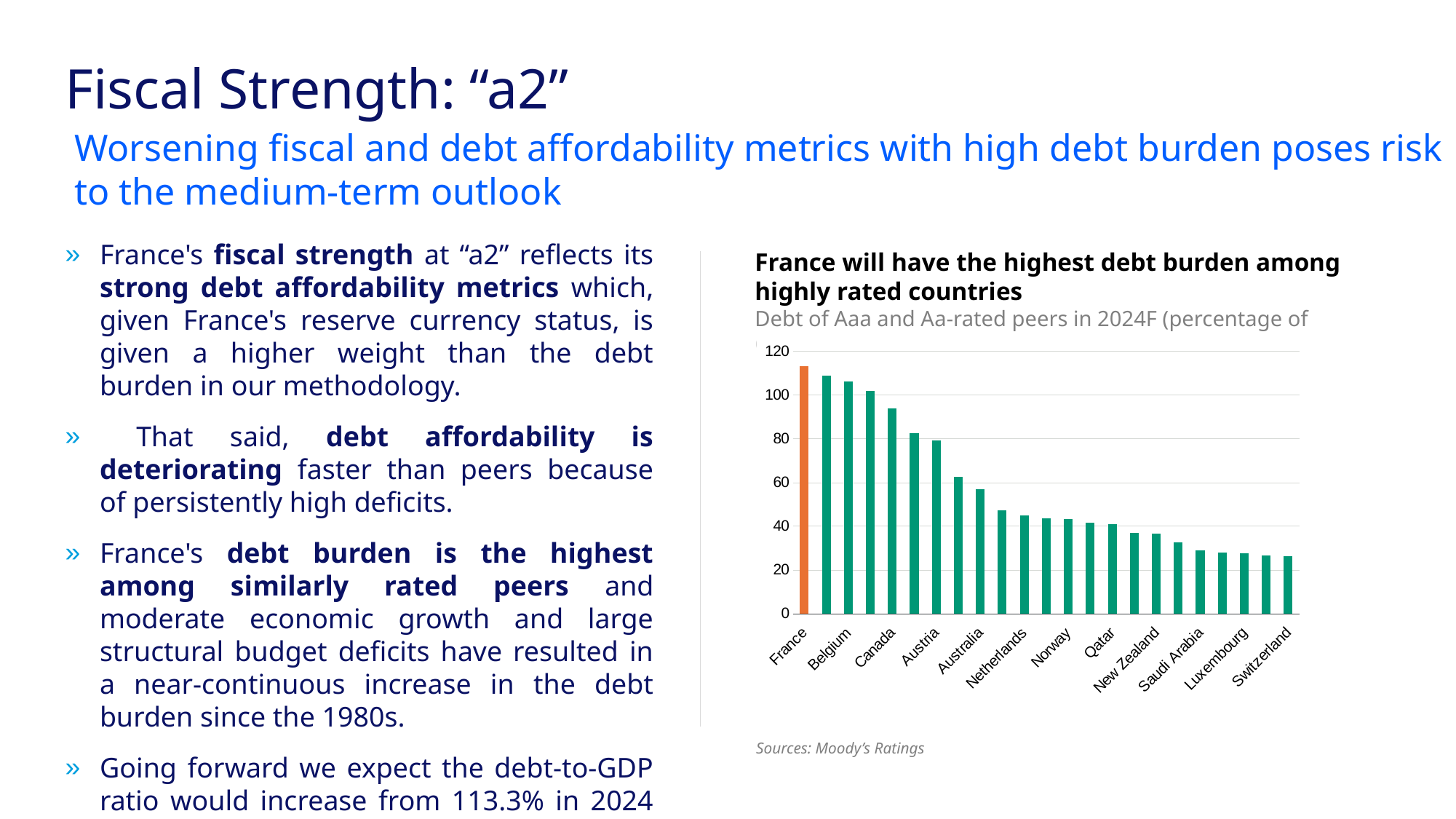
Is the value for Netherlands greater or less than 40? greater Is the value for Switzerland greater or less than 20? greater Which has a higher debt burden, Belgium or Austria? Belgium Which country has the highest debt burden in the chart? France Which country's bar is shown in a different colour (orange) from the others? France Which labeled country has the lowest debt burden in the chart? Switzerland What kind of chart is shown on the slide? bar chart Is the value for France greater or less than 100? greater What is the title of the chart? France will have the highest debt burden among highly rated countries Do the bar values rise or fall from left to right across the chart? fall